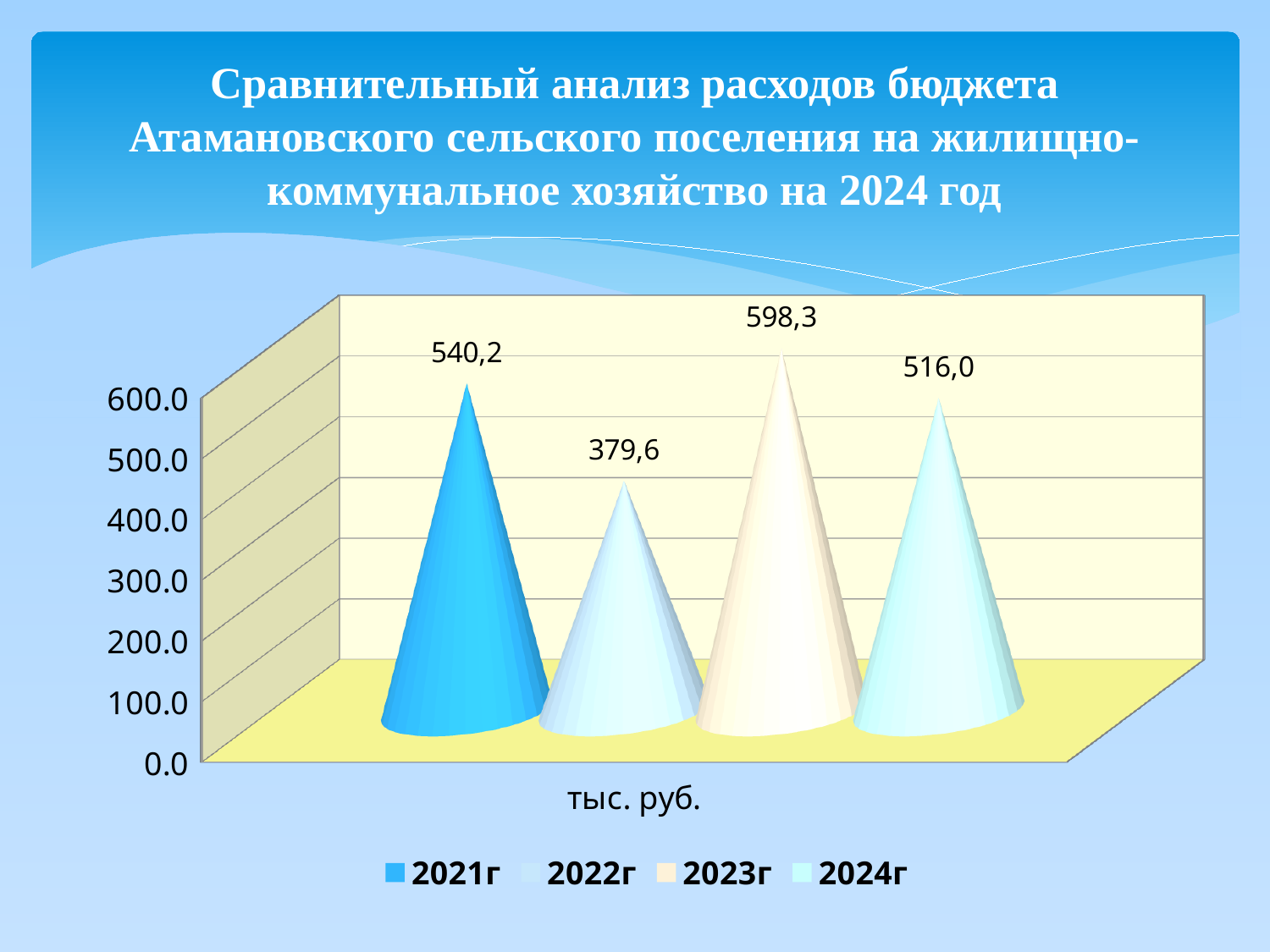
Which year has the lowest value? 2022г What is the value for 2021г? 540,2 What is the difference between the values for 2023г and 2021г? 58,1 What kind of chart is shown on the slide? bar chart What is the value for 2022г? 379,6 What is the value for 2023г? 598,3 Which is larger, the value for 2021г or the value for 2024г? 2021г What unit label is shown under the chart's category axis? тыс. руб. What is the value for 2024г? 516,0 How many series does the legend list? 4 What is the difference between the values for 2021г and 2022г? 160,6 Which year has the highest value? 2023г